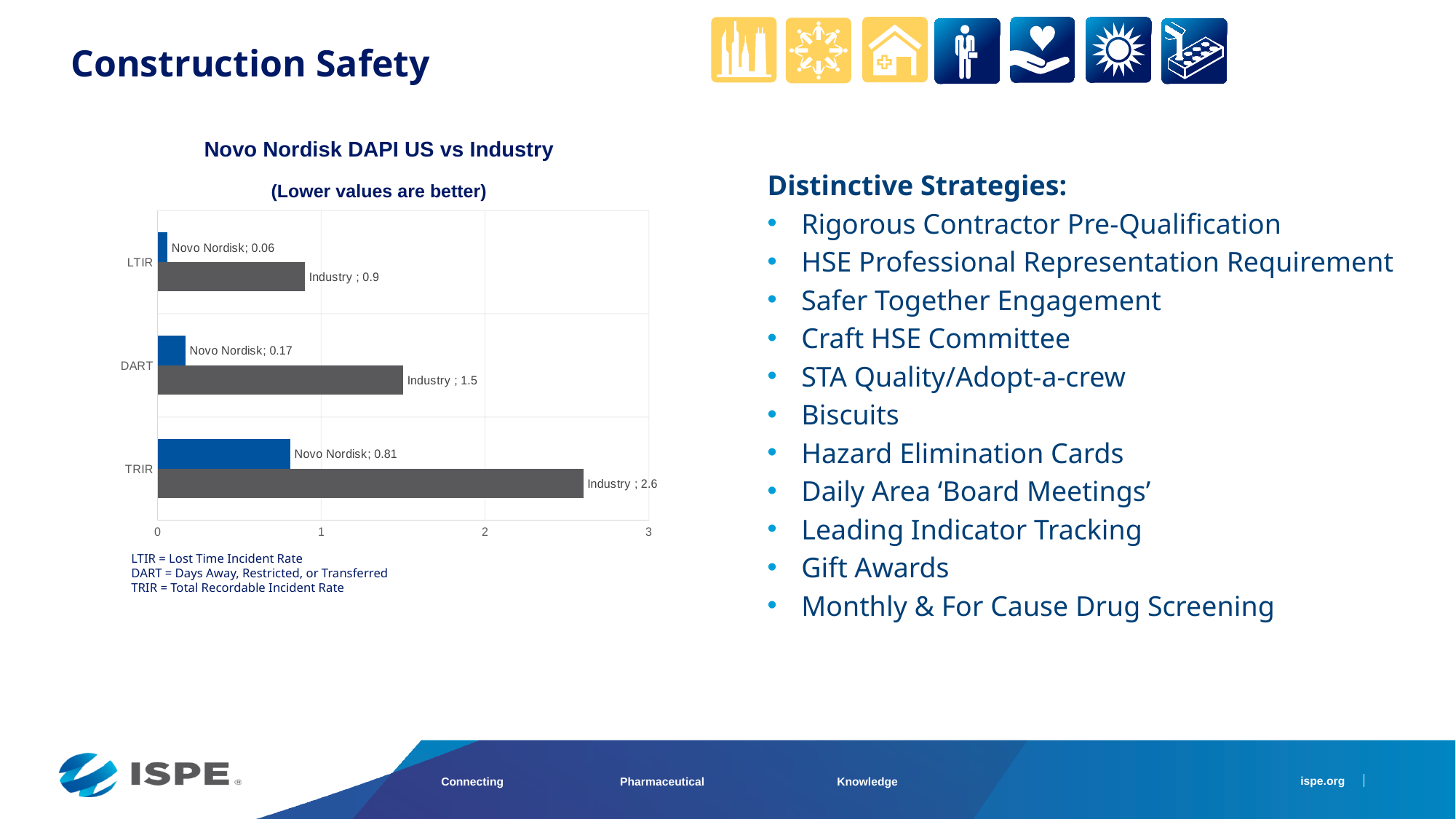
Which category has the lowest Novo Nordisk value? LTIR What is the difference between the Industry and Novo Nordisk values for TRIR? 1.79 What is the Novo Nordisk value for DART? 0.17 What is the Industry value for DART? 1.5 Which category has the highest Industry value? TRIR How many categories are shown on the chart? 3 Which is larger for DART: the Novo Nordisk value or the Industry value? Industry What is the Industry value for TRIR? 2.6 Is the Industry value for TRIR greater or less than 2? greater What is the title of the chart? Novo Nordisk DAPI US vs Industry What is the Novo Nordisk value for LTIR? 0.06 What kind of chart is shown on the slide? Bar chart